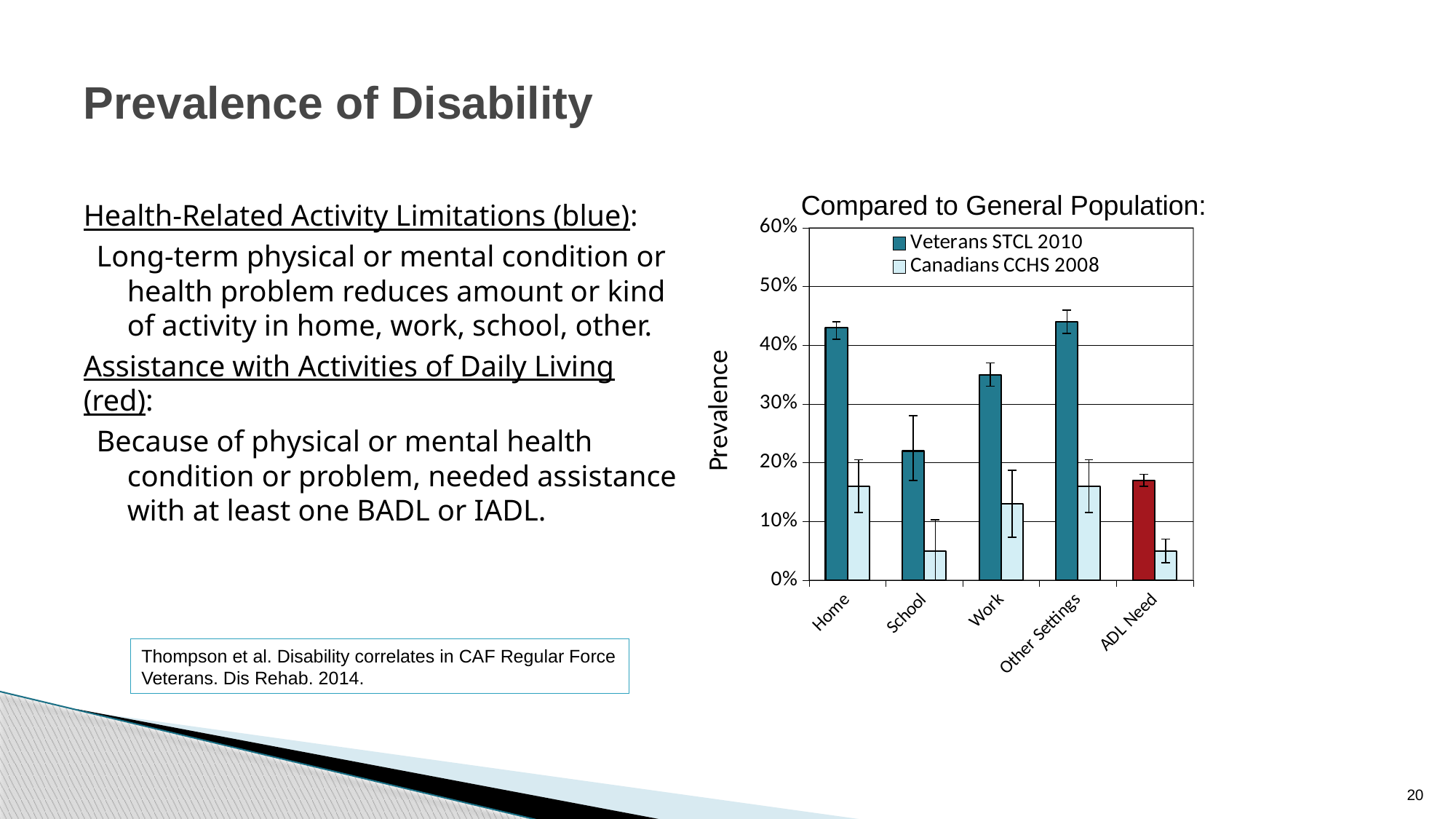
How many categories are shown on the x axis of the chart? 5 Is the Canadians CCHS 2008 value for School greater or less than 10%? less Is the Veterans STCL 2010 value for Home greater or less than 40%? greater For Veterans STCL 2010, which category has the larger value: Work or School? Work What is the title of the chart? Compared to General Population: For Home, which series has the larger value: Veterans STCL 2010 or Canadians CCHS 2008? Veterans STCL 2010 Is the Veterans STCL 2010 value for ADL Need greater or less than 20%? less What kind of chart is shown on the slide? bar chart How many series does the chart legend list? 2 What is the label on the y axis of the chart? Prevalence